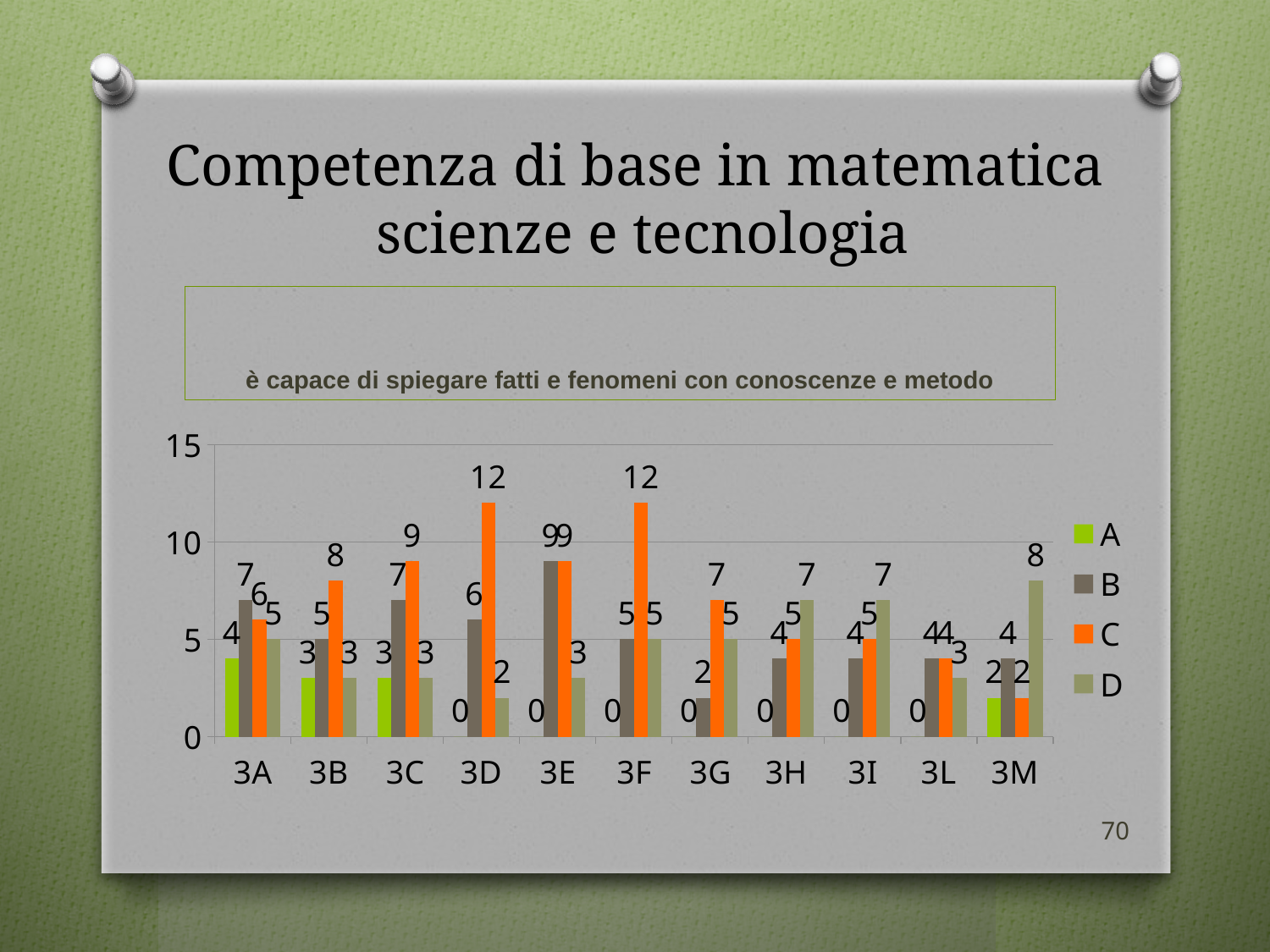
What kind of chart is shown on the slide? bar chart How many series does the legend list? 4 Which class has the highest value for series D? 3M What is the value of series D for class 3M? 8 Is the value of series C for class 3C greater or less than 5? greater What is the value of series A for class 3M? 2 For class 3B, what is the difference between the value of series C and the value of series A? 5 Which class has the lowest value for series B? 3G For class 3H, how much larger is the value of series D than the value of series B? 3 For class 3A, which is larger: series B or series C? B How many classes are shown on the x axis of the chart? 11 What is the value of series C for class 3D? 12